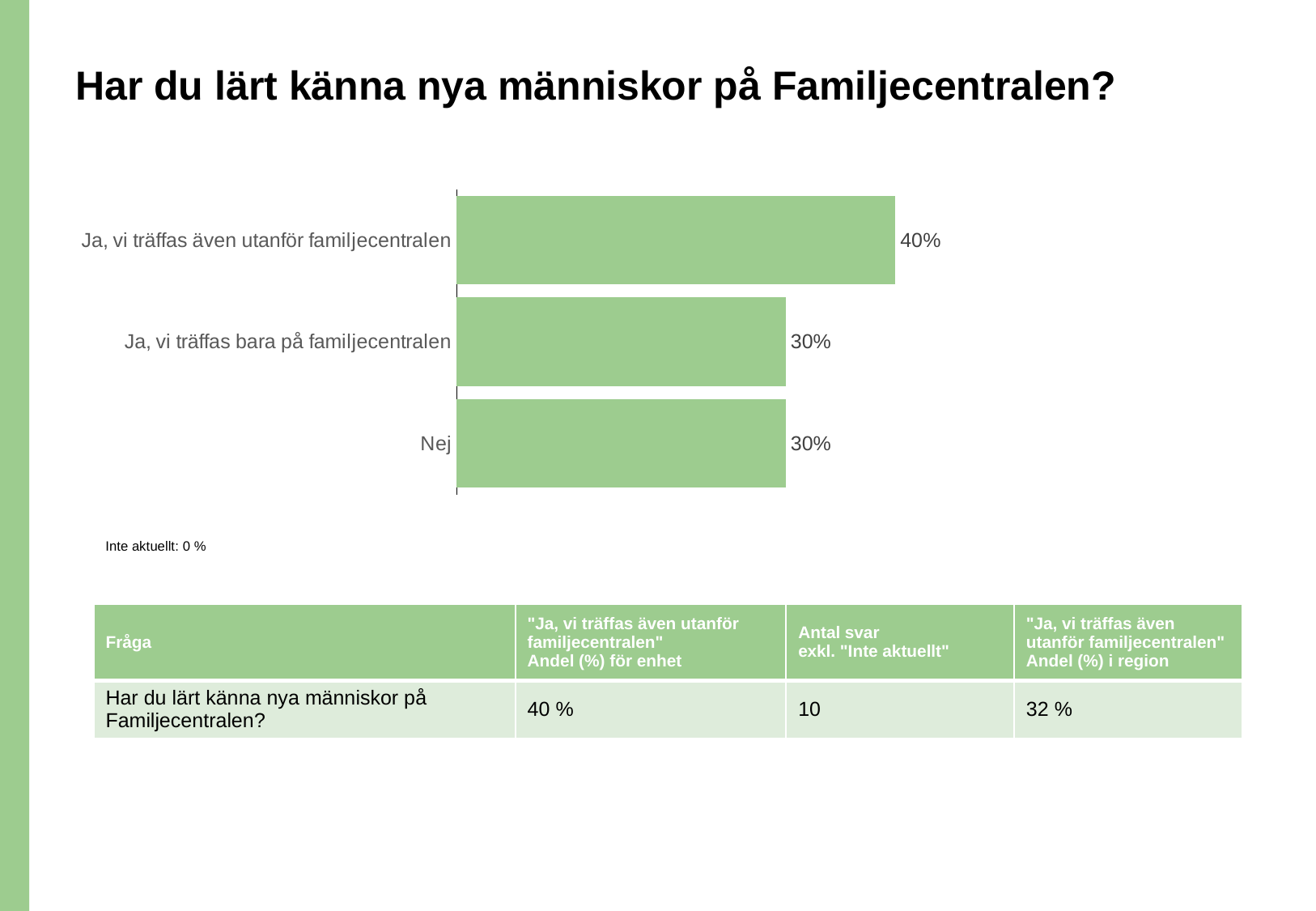
What is the total of the values for "Ja, vi träffas bara på familjecentralen" and "Nej"? 60% What is the difference between the values for "Ja, vi träffas även utanför familjecentralen" and "Nej"? 10% What kind of chart is shown on the slide? Bar chart What is the value for "Nej"? 30% Which is larger, the value for "Ja, vi träffas även utanför familjecentralen" or the value for "Ja, vi träffas bara på familjecentralen"? Ja, vi träffas även utanför familjecentralen Which category has the highest value? Ja, vi träffas även utanför familjecentralen What is the title of the slide? Har du lärt känna nya människor på Familjecentralen? How many categories are shown in the chart? 3 What is the value for "Ja, vi träffas bara på familjecentralen"? 30% What colour are the bars in the chart? Green What is the value for "Ja, vi träffas även utanför familjecentralen"? 40% What percentage is given for "Inte aktuellt" below the chart? 0 %